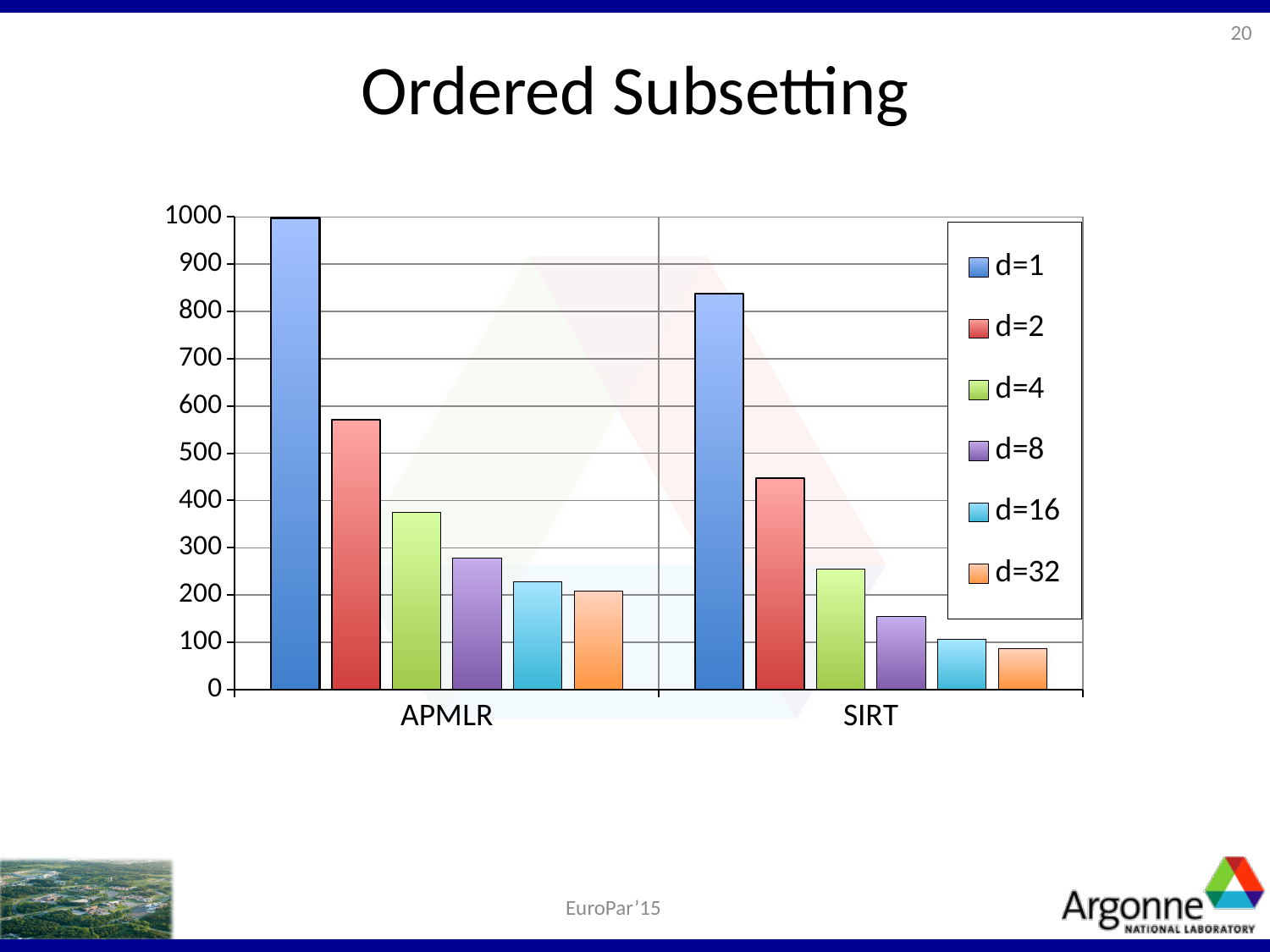
Is the value for d=8 in SIRT greater or less than 200? less How many categories are shown on the x axis? 2 Which series has the highest value for APMLR? d=1 Within each category, do the values rise or fall as d increases from d=1 to d=32? fall Is the value for d=16 in APMLR greater or less than 200? greater What kind of chart is shown on the slide? bar chart Is the value for d=2 in APMLR greater or less than 500? greater Which series has the lowest value for SIRT? d=32 What is the title of the slide containing the chart? Ordered Subsetting Which is larger, the d=1 value for APMLR or the d=1 value for SIRT? APMLR How many series does the legend list? 6